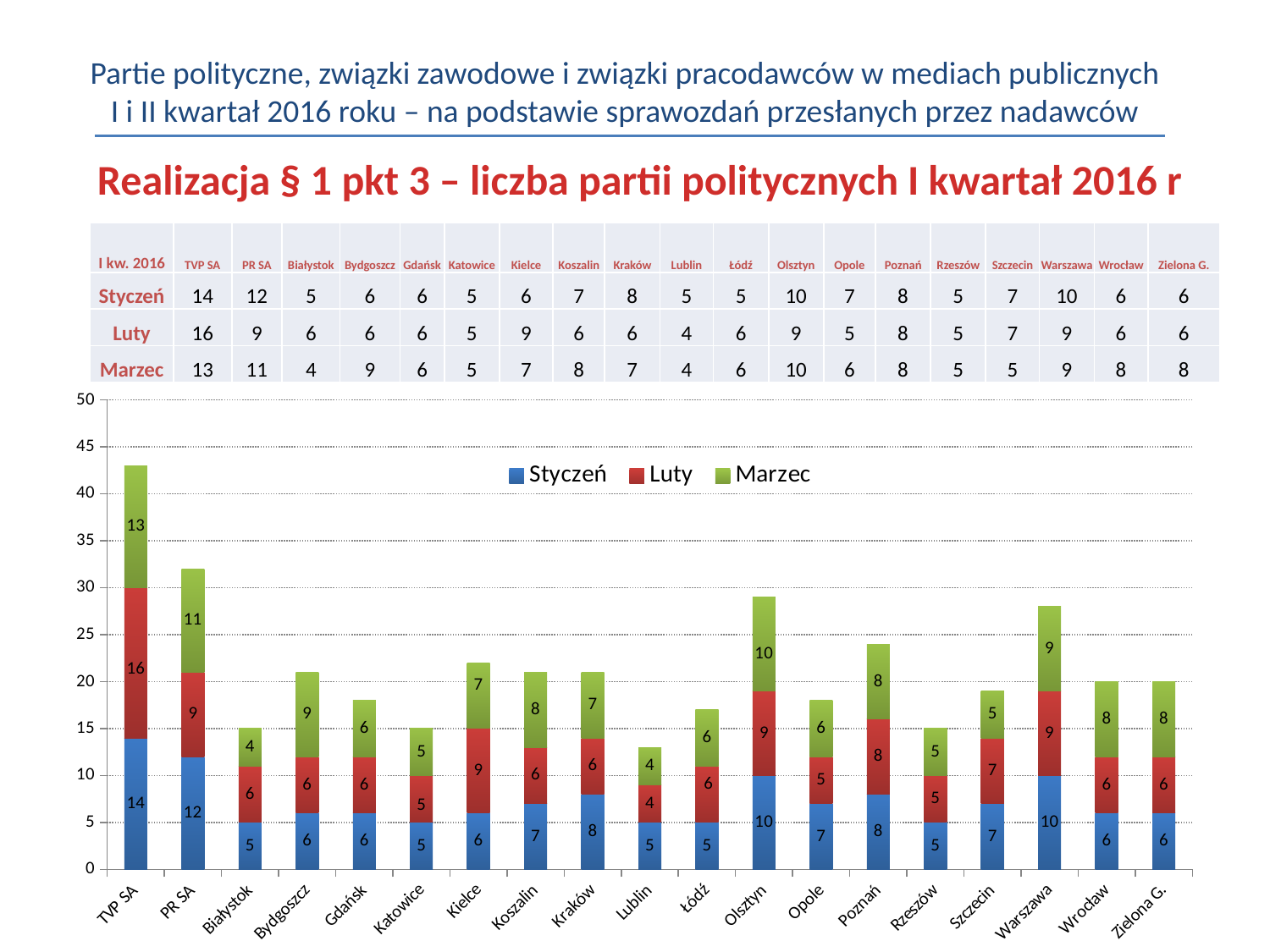
What is the total of the stacked bar for Lublin? 13 What is the total of the stacked bar for TVP SA? 43 What is the Marzec value for Olsztyn in the chart? 10 How many series does the chart legend list? 3 What kind of chart is shown on the slide? Stacked bar chart What is the difference between the Styczeń values for TVP SA and PR SA? 2 What are the three entries in the chart legend? Styczeń, Luty, Marzec Which category has the lowest stacked bar total? Lublin Which has the larger Marzec value, Bydgoszcz or Gdańsk? Bydgoszcz What is the Luty value for TVP SA in the chart? 16 Which category has the highest stacked bar total? TVP SA How many categories (broadcasters) are shown on the x axis of the chart? 19